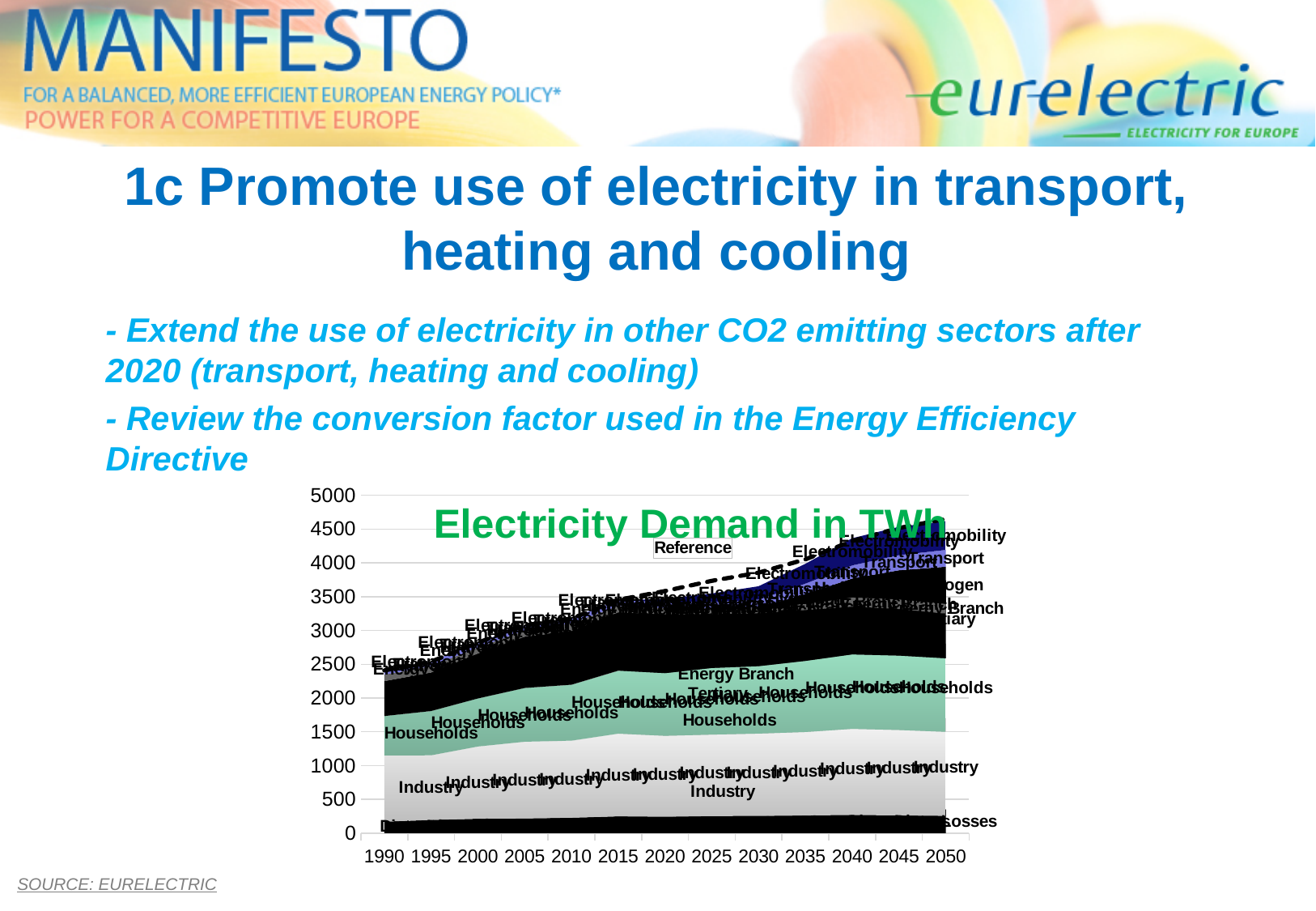
What kind of chart is shown on the slide? Stacked area chart Is the total electricity demand in 1990 greater or less than 3000 TWh? less Which sector forms the bottom-most large band of the stacked area chart, just above distribution losses? Industry What is the first year shown on the x axis of the chart? 1990 Does total electricity demand rise or fall from 1990 to 2050 in the chart? Rise What is the highest value shown on the y axis of the chart? 5000 How many years are labelled along the x axis of the chart? 13 What is the title of the chart on the slide? Electricity Demand in TWh Is the total electricity demand in 2020 greater or less than 3000 TWh? greater What is the last year shown on the x axis of the chart? 2050 Is the total electricity demand in 1990 greater or less than 2000 TWh? greater